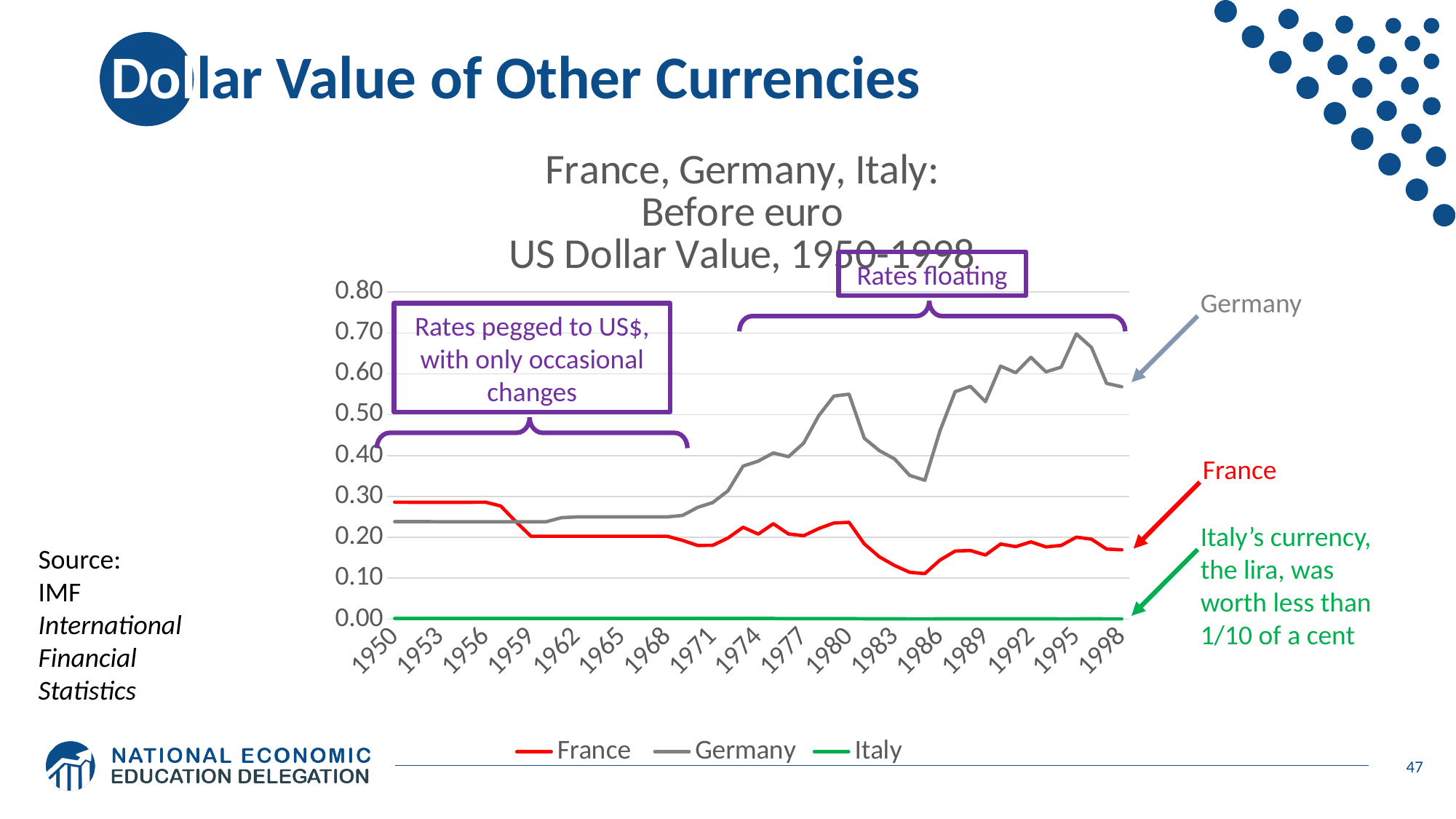
In 1998, which is larger, the value for Germany or the value for France? Germany In 1950, which is larger, the value for France or the value for Germany? France What colour is the Germany line in the chart? grey How many series does the legend list? 3 Does the Germany line generally rise or fall from 1950 to 1998? rise Which series has the lowest values throughout the chart? Italy Is the value for Germany in 1950 greater or less than 0.30? less Is the value for France in 1986 greater or less than 0.20? less Which series reaches the highest value on the chart? Germany What kind of chart is shown on the slide? line chart Which series are listed in the chart legend? France, Germany, Italy Is the value for Germany in 1995 greater or less than 0.60? greater